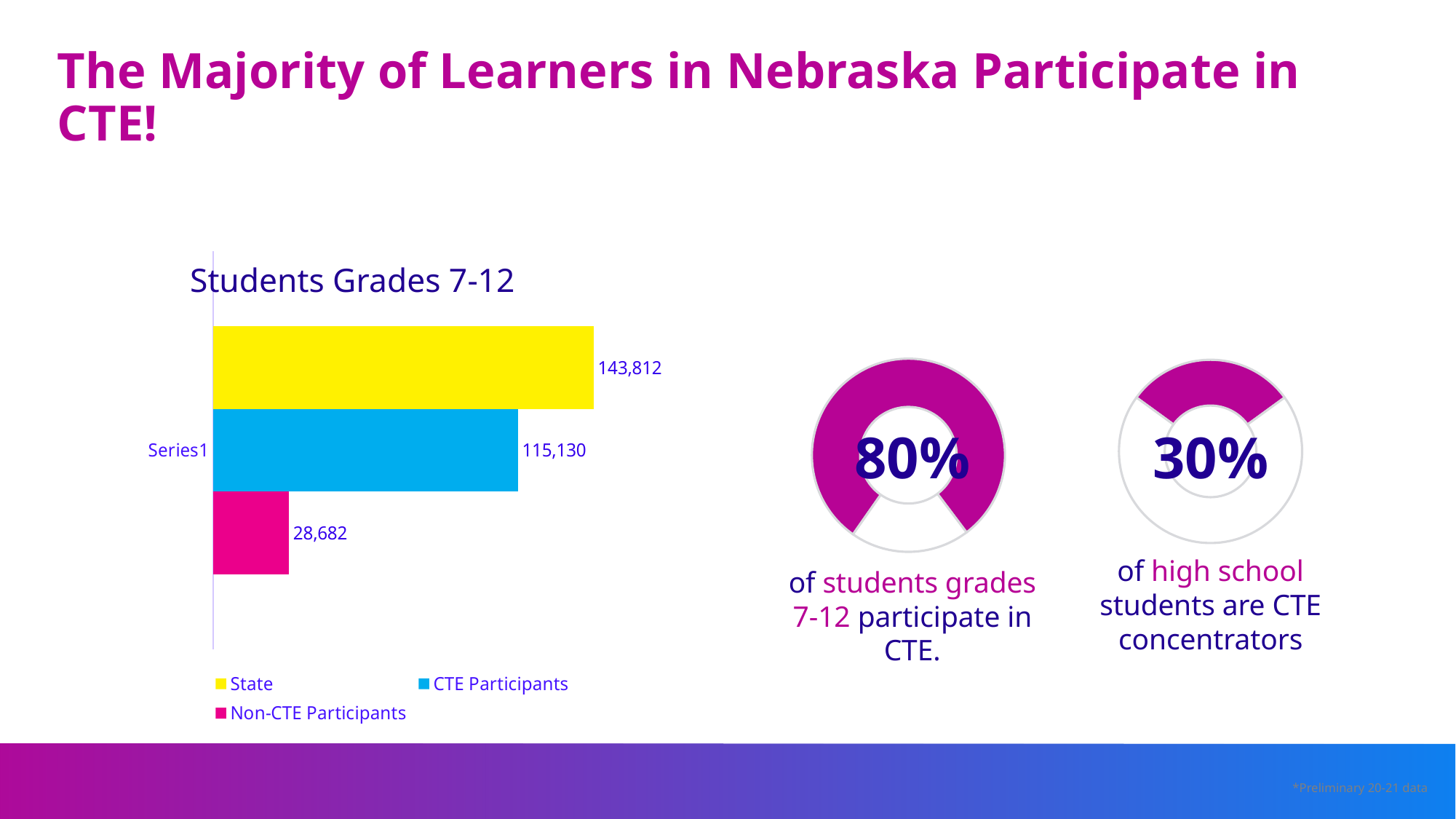
In the 'Students Grades 7-12' bar chart, which series has the highest value? State In the 'Students Grades 7-12' bar chart, which is larger: CTE Participants or Non-CTE Participants? CTE Participants In the 'Students Grades 7-12' bar chart, what is the value for State? 143,812 In the 'Students Grades 7-12' bar chart, what is the difference between the CTE Participants value and the Non-CTE Participants value? 86,448 In the right donut chart, what percentage of high school students are CTE concentrators? 30% What kind of chart is the 'Students Grades 7-12' chart? Bar chart In the 'Students Grades 7-12' bar chart, what is the value for Non-CTE Participants? 28,682 In the 'Students Grades 7-12' bar chart, which series has the lowest value? Non-CTE Participants In the 'Students Grades 7-12' bar chart, what is the value for CTE Participants? 115,130 In the left donut chart, what percentage of students in grades 7-12 participate in CTE? 80% How many series does the legend of the 'Students Grades 7-12' chart list? 3 In the 'Students Grades 7-12' bar chart, what is the difference between the State value and the CTE Participants value? 28,682